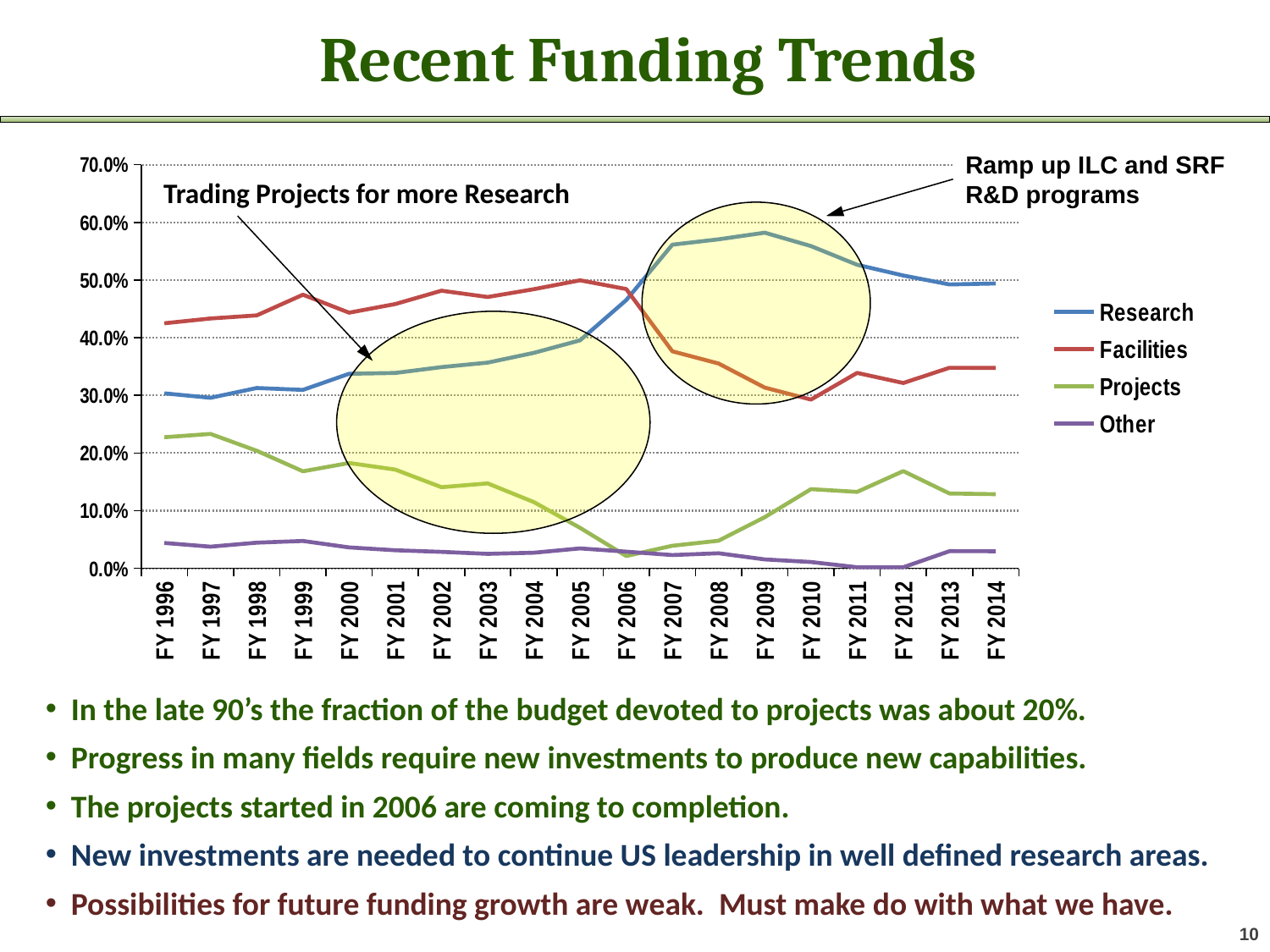
Which series is drawn with the blue line? Research In FY 1996, which is larger: Facilities or Research? Facilities What kind of chart is shown on the slide? Line chart Is the value for Research in FY 2009 greater or less than 50%? greater Is the value for Projects in FY 1999 greater or less than 20%? less How many fiscal years are plotted along the x axis? 19 How many series does the chart's legend list? 4 Is the value for Projects in FY 2006 greater or less than 10%? less Which series has the lowest value in FY 2012? Other In FY 2014, which is larger: Research or Facilities? Research Does the Research series rise or fall from FY 2000 to FY 2009? Rise